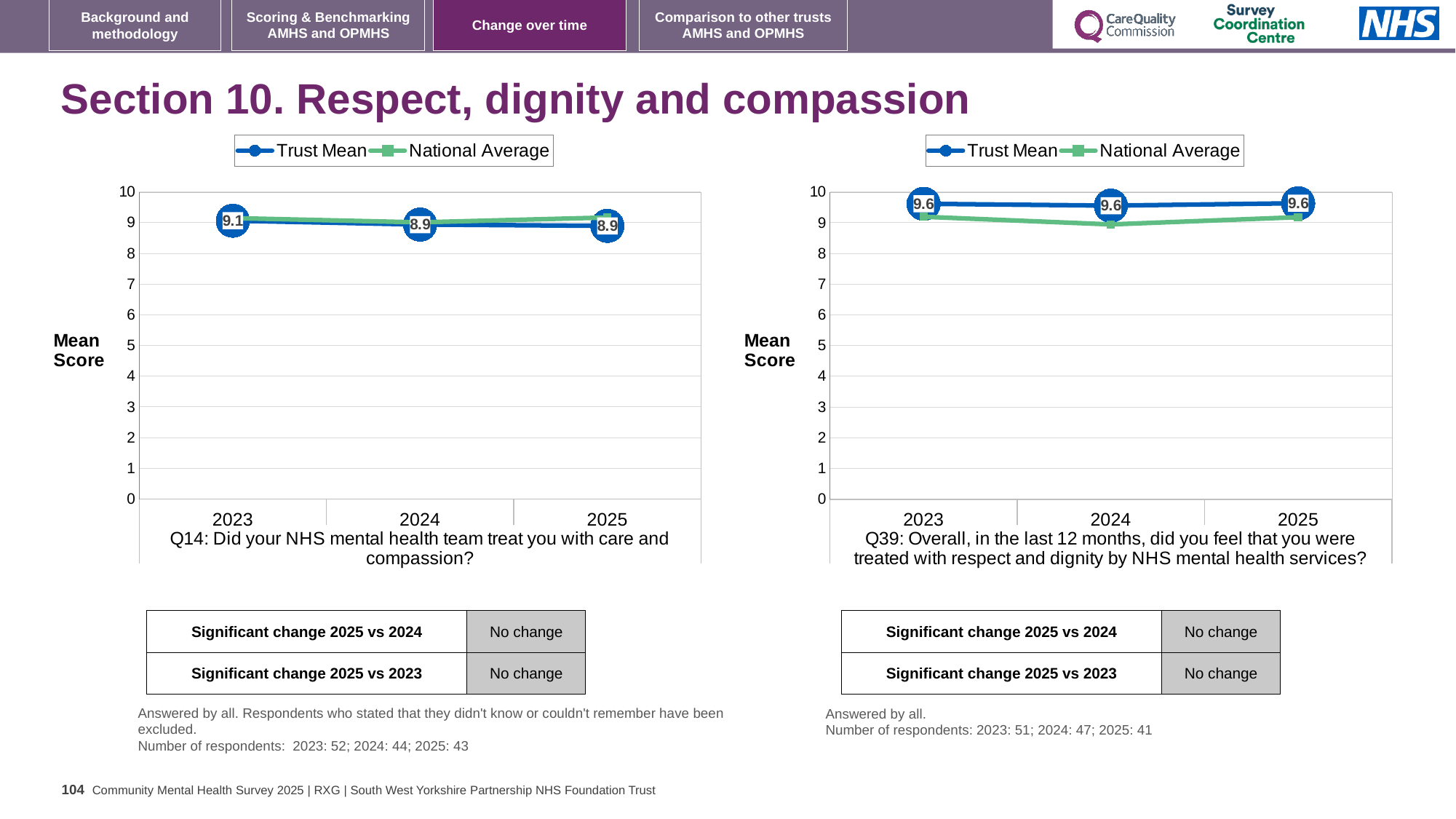
In the Q39 chart on the right, does the Trust Mean rise, fall or stay flat from 2023 to 2025? Stays flat How many years are plotted on the x axis of the Q14 chart on the left? 3 How many series does the legend of the Q39 chart on the right list? 2 In the Q39 chart on the right, what is the Trust Mean score for 2024? 9.6 What type of chart is used for Q14 on the left? Line chart In the Q14 chart on the left, what is the difference between the Trust Mean scores for 2023 and 2025? 0.2 In the Q14 chart on the left, which year has the highest Trust Mean score? 2023 In the Q14 chart on the left, what is the Trust Mean score for 2023? 9.1 In the Q14 chart on the left, does the Trust Mean rise or fall from 2023 to 2024? Falls In the Q14 chart on the left, what is the Trust Mean score for 2025? 8.9 In the Q39 chart on the right, which is larger in 2024, the Trust Mean or the National Average? Trust Mean In the Q39 chart on the right, is the National Average for 2024 greater or less than 8? greater